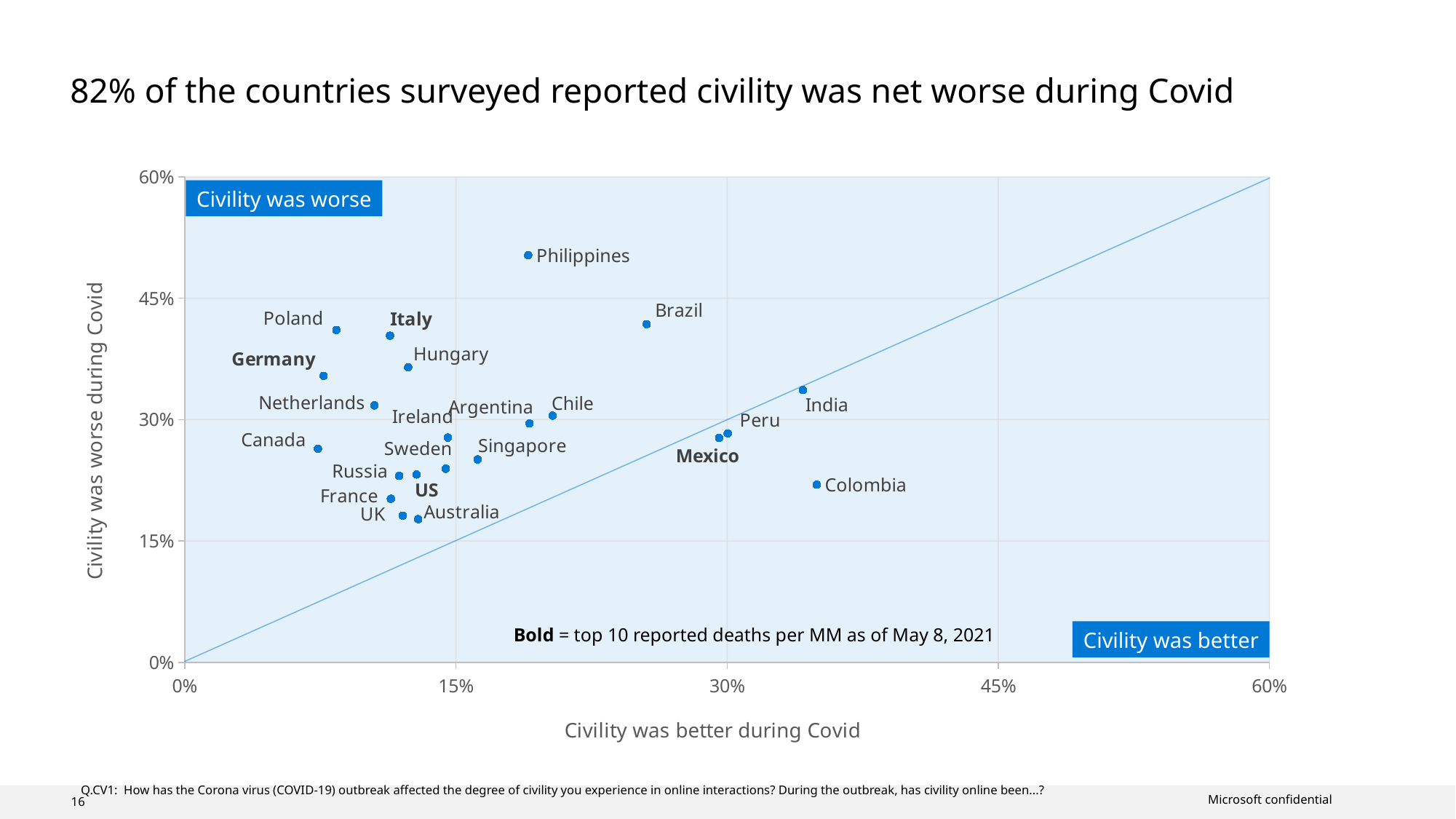
According to the note on the chart, what do bold country labels indicate? Top 10 reported deaths per MM as of May 8, 2021 Is the 'Civility was better during Covid' value for India greater or less than 30%? greater Is the 'Civility was worse during Covid' value for the Philippines greater or less than 45%? greater Which has a higher 'Civility was worse during Covid' value, the Philippines or Brazil? Philippines Is the 'Civility was better during Covid' value for Brazil greater or less than 15%? greater What kind of chart is shown on the slide? Scatter chart Which has a higher 'Civility was better during Covid' value, Colombia or Canada? Colombia What is the title of the x axis? Civility was better during Covid Which country has the highest value for 'Civility was worse during Covid'? Philippines How many countries are plotted on the chart? 22